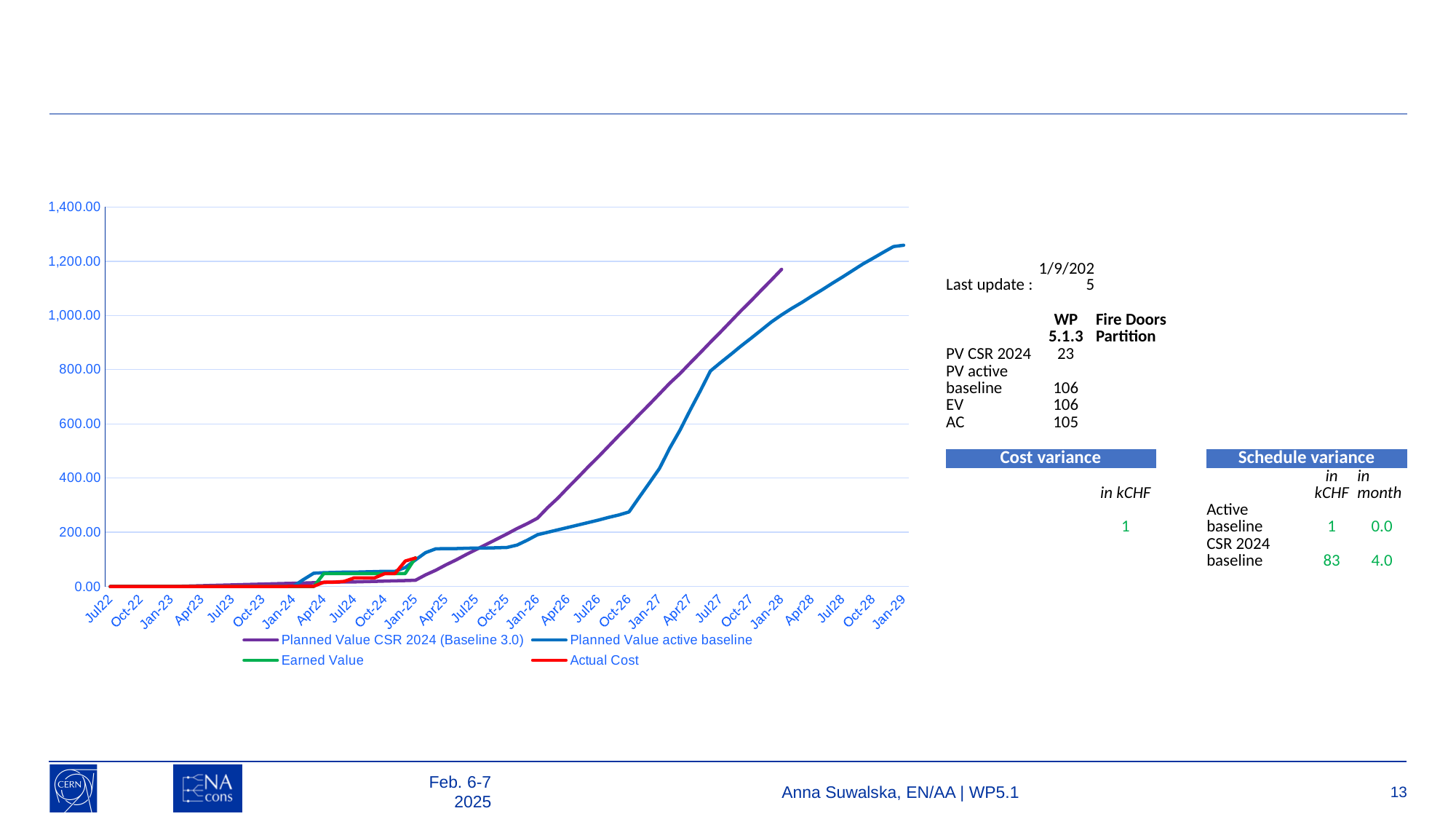
Is the value of Planned Value active baseline at Oct-26 greater or less than 400.00? less How many date labels are shown along the x axis of the chart? 27 What colour is the Actual Cost line in the chart? red At Apr25, which is larger: Planned Value active baseline or Planned Value CSR 2024 (Baseline 3.0)? Planned Value active baseline Does the Planned Value active baseline line rise or fall from Jul22 to Jan-29? rise At Jan-28, which is larger: Planned Value CSR 2024 (Baseline 3.0) or Planned Value active baseline? Planned Value CSR 2024 (Baseline 3.0) Is the value of Planned Value CSR 2024 (Baseline 3.0) at Jan-28 greater or less than 1,000.00? greater Which series reaches the highest value anywhere on the chart? Planned Value active baseline How many series does the chart legend list? 4 Is the value of Planned Value CSR 2024 (Baseline 3.0) at Jan-26 greater or less than 200.00? greater What kind of chart is shown on the slide? line chart